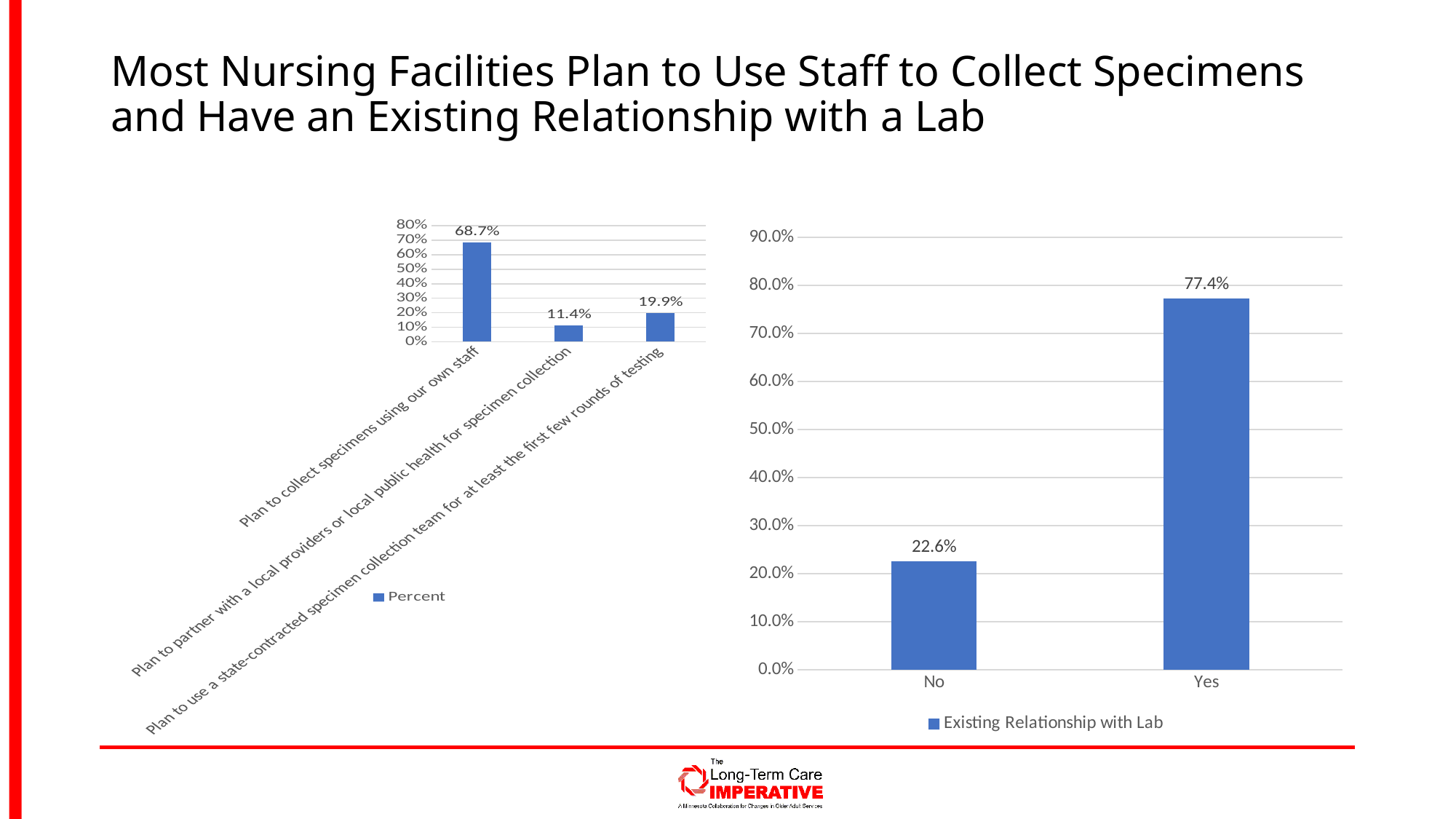
In the right chart, which category is higher, 'No' or 'Yes'? Yes In the right chart, what is the value for 'Yes'? 77.4% What is the legend entry of the right chart? Existing Relationship with Lab What type of chart is the right chart? Bar chart In the left chart, how many categories are plotted? 3 In the left chart, what is the value for 'Plan to collect specimens using our own staff'? 68.7% In the right chart, what is the difference between the 'Yes' and 'No' values? 54.8% In the left chart, what is the value for 'Plan to partner with a local providers or local public health for specimen collection'? 11.4% In the left chart, what is the difference between the highest and lowest values? 57.3% In the left chart, what is the value for 'Plan to use a state-contracted specimen collection team for at least the first few rounds of testing'? 19.9% In the right chart, what is the value for 'No'? 22.6% In the left chart, which category has the lowest value? Plan to partner with a local providers or local public health for specimen collection